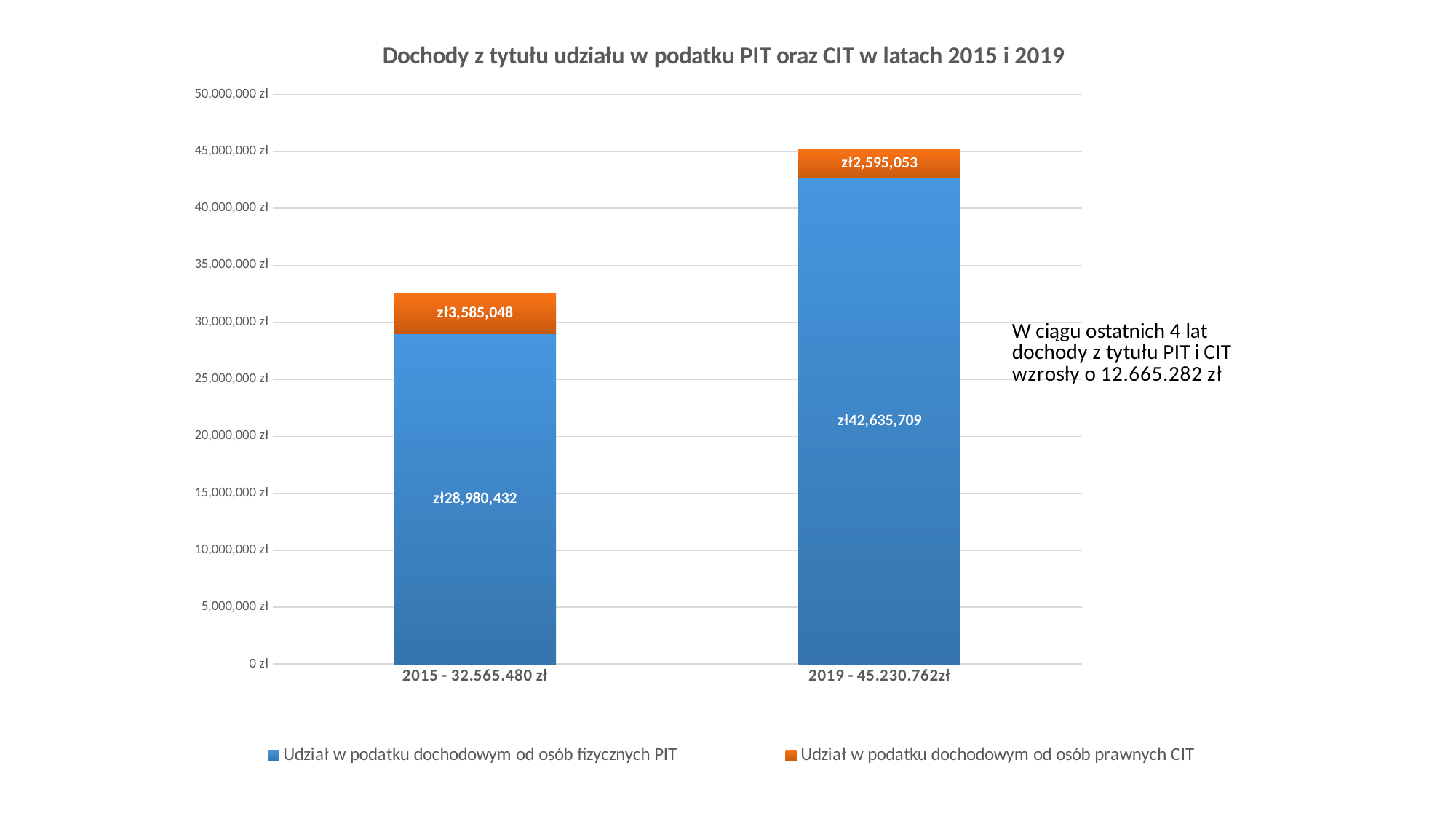
What is the CIT value for 2015? zł3,585,048 What is the CIT value (Udział w podatku dochodowym od osób prawnych CIT) for 2019? zł2,595,053 What is the difference between the CIT values for 2015 and 2019? zł989,995 What is the PIT value for 2019? zł42,635,709 What type of chart is shown on the slide? Stacked bar chart What is the total of the stacked bar for 2015? 32.565.480 zł How many series does the legend list? 2 How many categories (years) are shown on the x axis? 2 What is the PIT value (Udział w podatku dochodowym od osób fizycznych PIT) for 2015? zł28,980,432 Which year has the higher CIT value, 2015 or 2019? 2015 By how much did the PIT value increase from 2015 to 2019? zł13,655,277 What is the total of the stacked bar for 2019? 45.230.762 zł